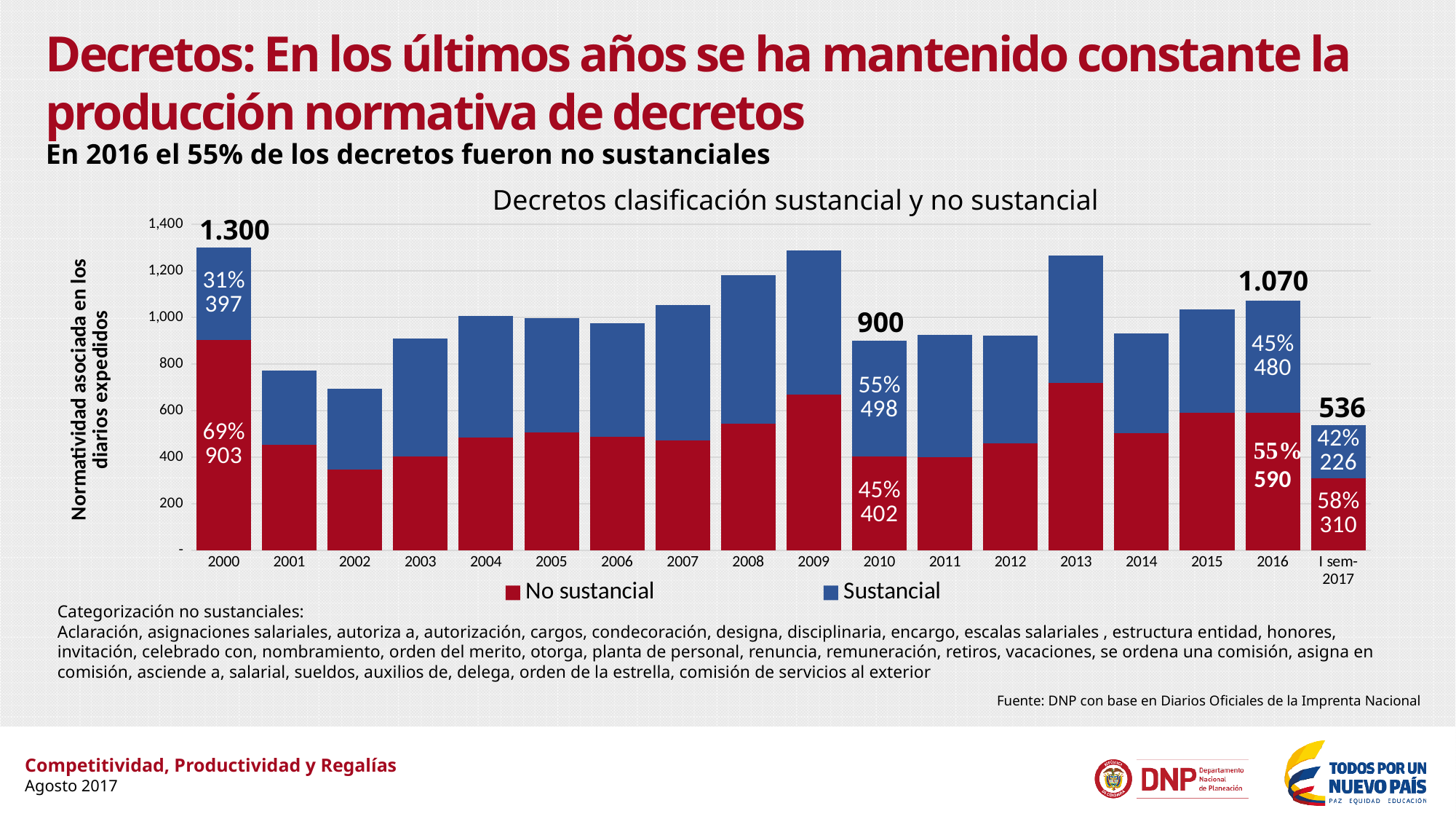
How many series does the legend list? 2 What kind of chart is shown on the slide? Stacked bar chart What is the total of the stacked bar for 2016? 1.070 What percentage of decrees in 2016 were No sustancial, according to the data label? 55% What is the difference between the No sustancial value for 2000 and the No sustancial value for 2016? 313 Is the total value for 2002 greater or less than 800? less How many categories are shown on the x axis? 18 Which is larger in 2010: the Sustancial value or the No sustancial value? Sustancial Is the total value for 2009 greater or less than 1,200? greater What is the total of the stacked bar for I sem-2017? 536 What is the value of the No sustancial series for 2000? 903 What is the value of the Sustancial series for 2010? 498